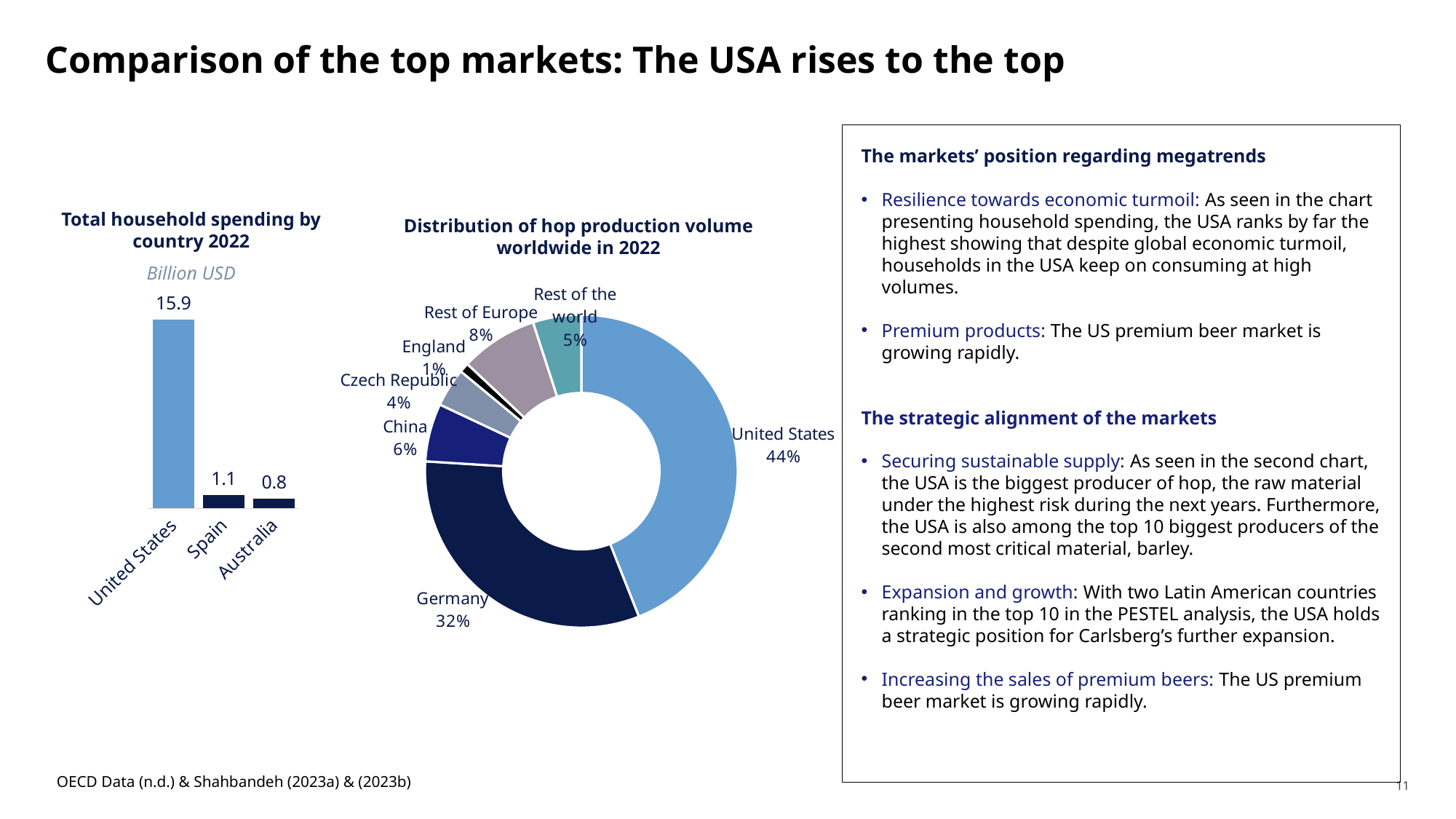
In the 'Total household spending by country 2022' chart, which country has the lowest value? Australia In the 'Total household spending by country 2022' chart, what is the value for Spain? 1.1 In the 'Total household spending by country 2022' chart, how many countries are shown? 3 In the 'Distribution of hop production volume worldwide in 2022' chart, which category has the smallest share? England In the 'Distribution of hop production volume worldwide in 2022' chart, which is larger: China or Czech Republic? China In the 'Distribution of hop production volume worldwide in 2022' chart, which category has the largest share? United States What unit is shown under the title of the 'Total household spending by country 2022' chart? Billion USD In the 'Total household spending by country 2022' chart, what is the difference between the United States and Spain? 14.8 What kind of chart is 'Total household spending by country 2022'? Bar chart In the 'Total household spending by country 2022' chart, what is the value for the United States? 15.9 In the 'Distribution of hop production volume worldwide in 2022' chart, what share does Germany have? 32% In the 'Distribution of hop production volume worldwide in 2022' chart, how many categories are shown? 7